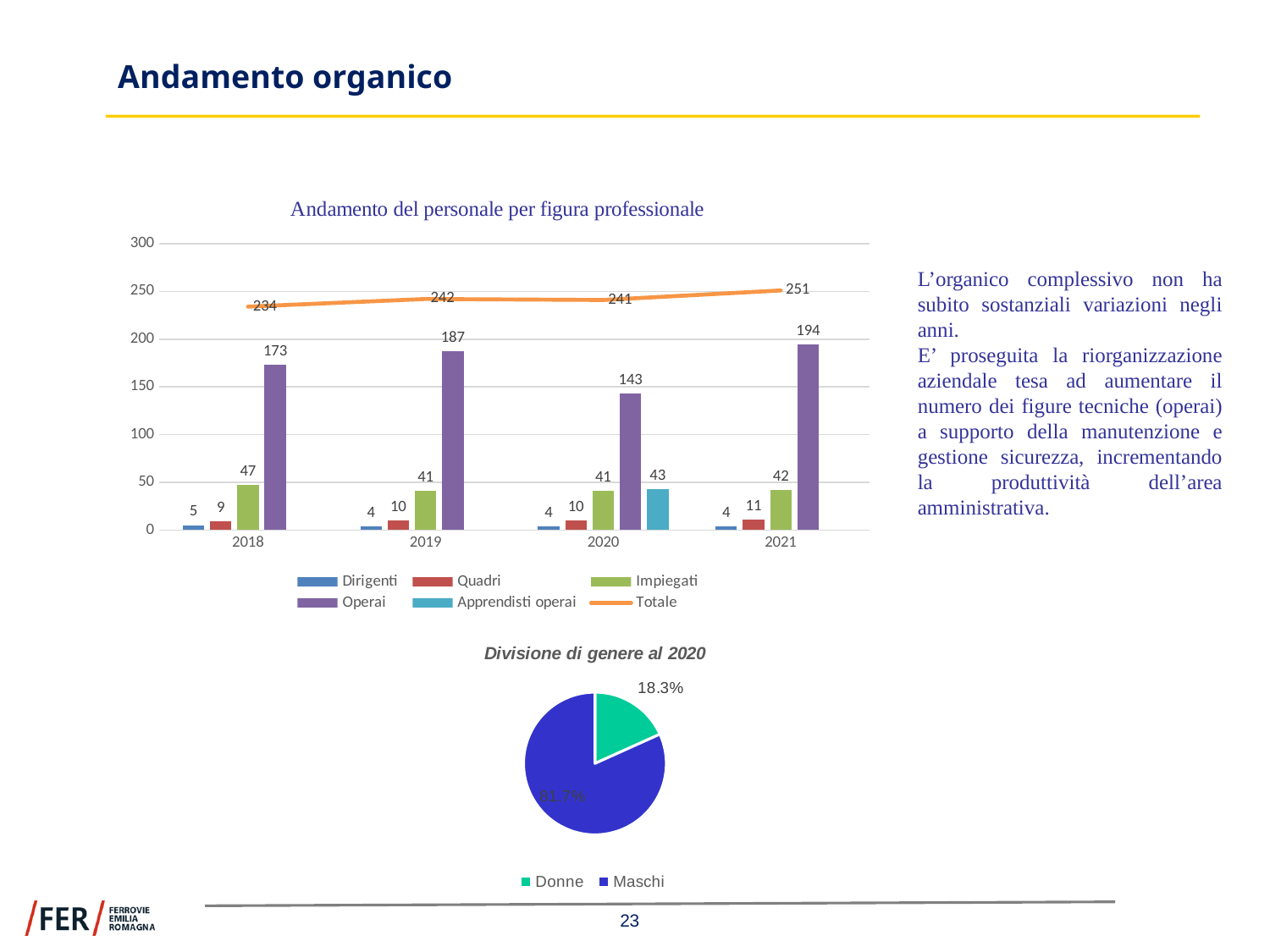
In the chart 'Andamento del personale per figura professionale', what is the value for Operai in 2021? 194 In the chart 'Andamento del personale per figura professionale', what is the Totale value for 2018? 234 What kind of chart is 'Divisione di genere al 2020'? Pie chart In the chart 'Andamento del personale per figura professionale', in which year is the Totale value lowest? 2018 In the chart 'Andamento del personale per figura professionale', how many years are shown on the x axis? 4 In the chart 'Andamento del personale per figura professionale', what is the value for Impiegati in 2018? 47 In the chart 'Andamento del personale per figura professionale', how many series does the legend list? 6 In the chart 'Andamento del personale per figura professionale', which is larger: Quadri in 2021 or Quadri in 2018? Quadri in 2021 In the chart 'Divisione di genere al 2020', what share of the pie is Donne? 18.3% In the chart 'Andamento del personale per figura professionale', in which year is the Operai value highest? 2021 In the chart 'Andamento del personale per figura professionale', what is the difference between the Operai values in 2019 and 2020? 44 In the chart 'Andamento del personale per figura professionale', what is the value for Apprendisti operai in 2020? 43